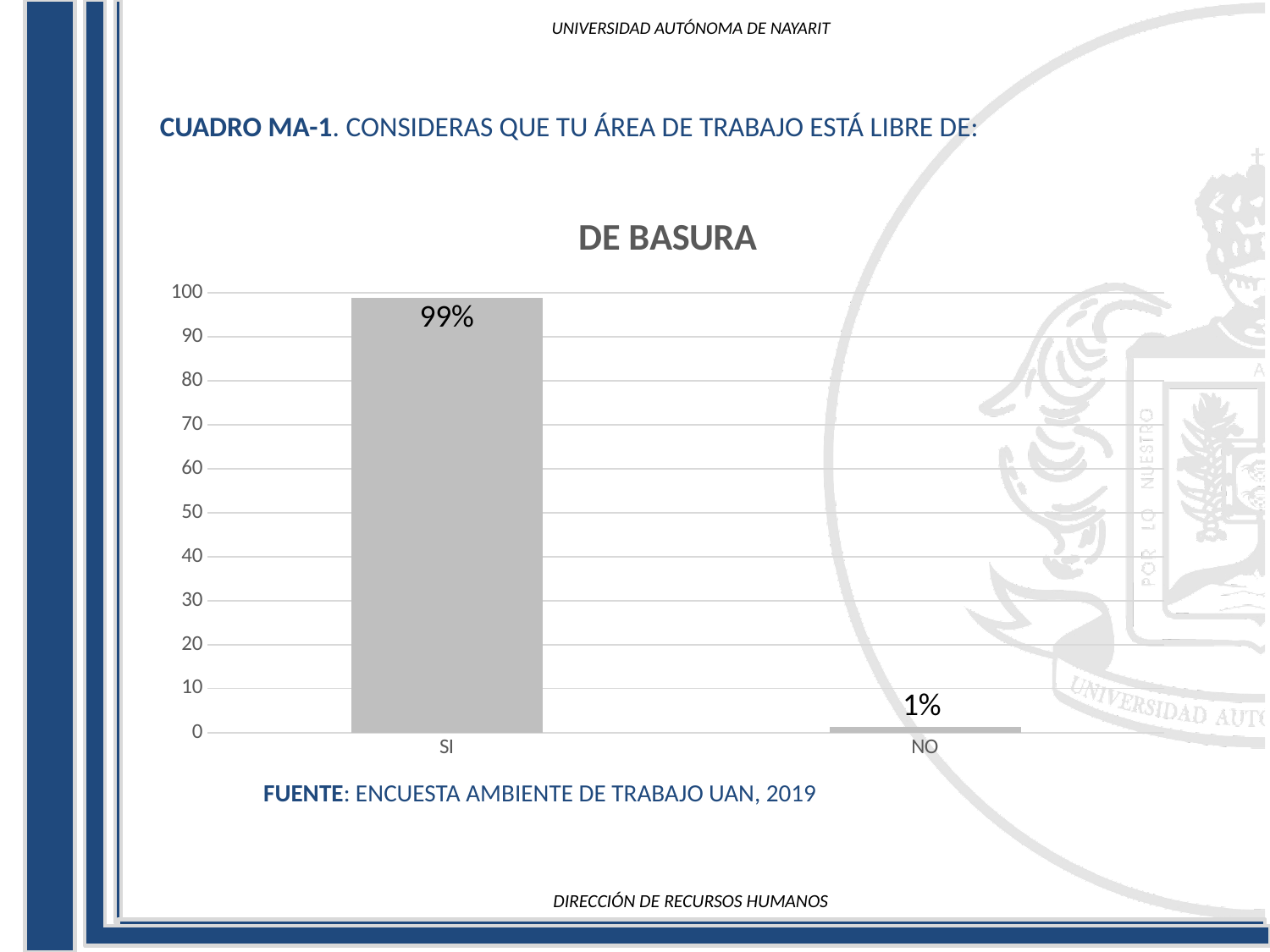
What is the value for SI? 99% What is the value for NO? 1% How many categories are shown on the x axis? 2 Is the value for SI greater or less than 50? greater What is the source cited below the chart? ENCUESTA AMBIENTE DE TRABAJO UAN, 2019 What kind of chart is shown? bar chart Which category has the lowest value? NO What is the difference between the values for SI and NO? 98% Is the value for NO greater or less than 10? less Which is larger, the value for SI or the value for NO? SI What is the title of the chart? DE BASURA Which category has the highest value? SI